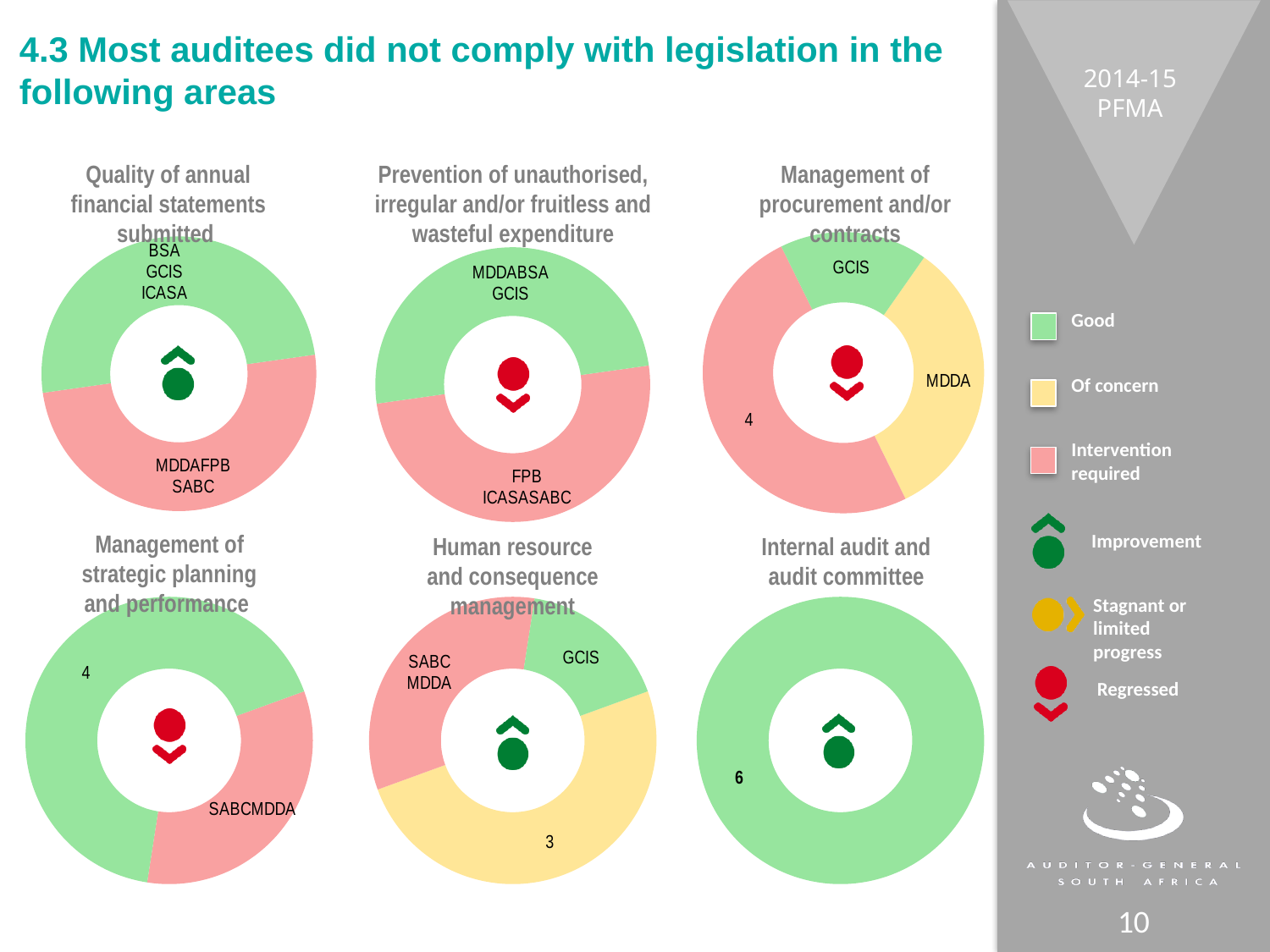
In the 'Human resource and consequence management' chart, how many auditees are in the yellow 'Of concern' segment? 3 What kind of charts are shown on the slide? Pie (donut) charts In the 'Management of strategic planning and performance' chart, how many auditees are in the green 'Good' segment? 4 In the 'Human resource and consequence management' chart, which auditee is in the green 'Good' segment? GCIS In the 'Management of procurement and/or contracts' chart, which auditee is in the yellow 'Of concern' segment? MDDA How many charts are shown on the slide? 6 What does the yellow colour represent in the legend? Of concern In the 'Quality of annual financial statements submitted' chart, which auditees are in the green 'Good' segment? BSA, GCIS, ICASA In the 'Internal audit and audit committee' chart, how many auditees are in the green 'Good' segment? 6 In the 'Prevention of unauthorised, irregular and/or fruitless and wasteful expenditure' chart, which auditees are in the red 'Intervention required' segment? FPB, ICASA, SABC Which chart on the slide has all of its auditees in the green 'Good' segment? Internal audit and audit committee In the 'Management of procurement and/or contracts' chart, how many auditees are in the red 'Intervention required' segment? 4